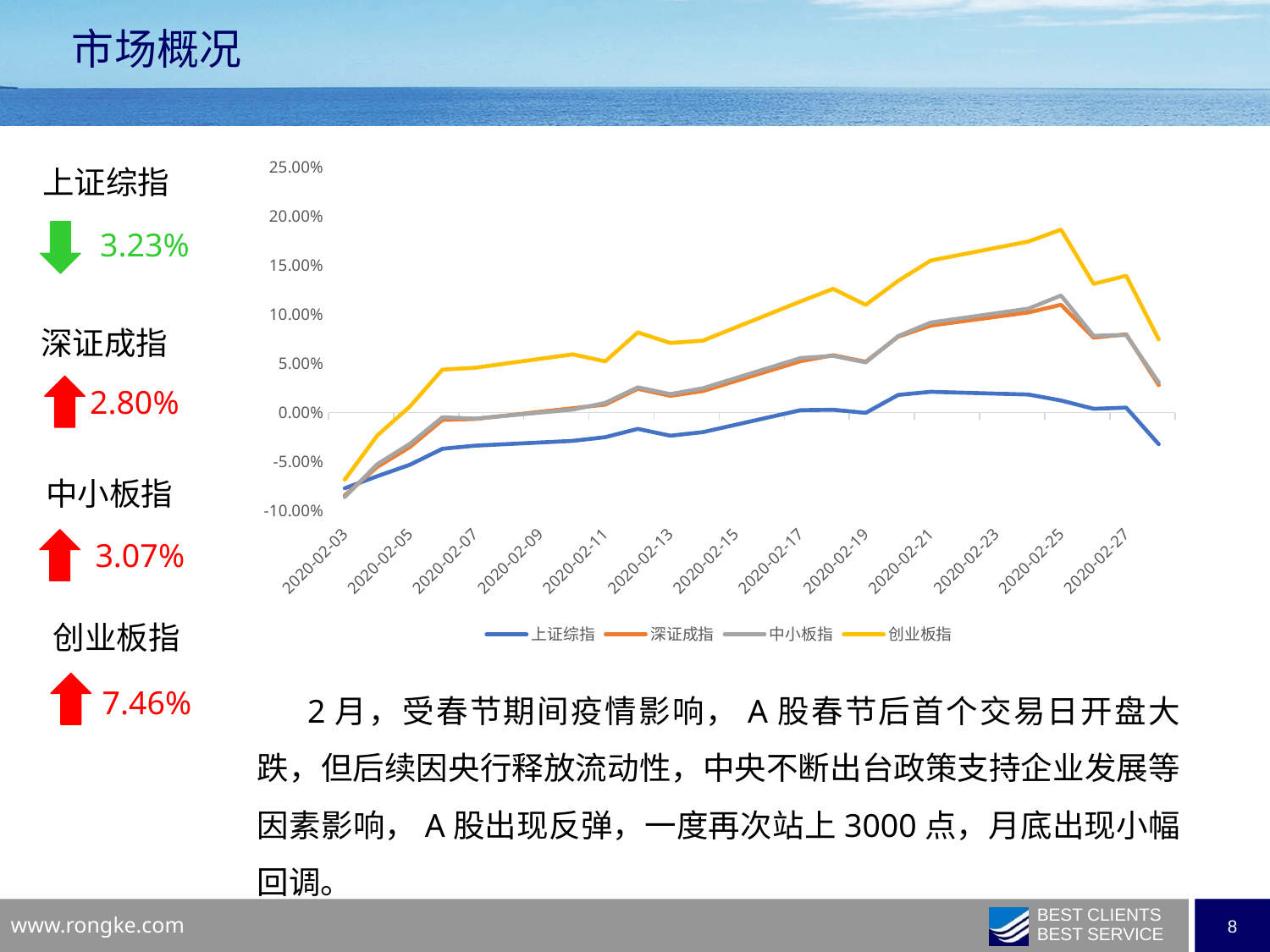
How many series does the chart legend list? 4 Which series reaches the highest value on the chart? 创业板指 Which series has the lowest value at the end of the period (2020-02-28)? 上证综指 On 2020-02-25, which series has the larger value, 创业板指 or 上证综指? 创业板指 What is the first date label on the x axis? 2020-02-03 Is the value for 上证综指 on 2020-02-03 greater or less than -5.00%? less What kind of chart is shown on the slide? line chart Is the value for 创业板指 on 2020-02-25 greater or less than 15.00%? greater Does the 创业板指 line generally rise or fall from 2020-02-03 to 2020-02-25? rise What colour is the 创业板指 line in the legend? yellow Is the value for 创业板指 on 2020-02-07 greater or less than 0.00%? greater How many date labels are shown on the x axis? 13